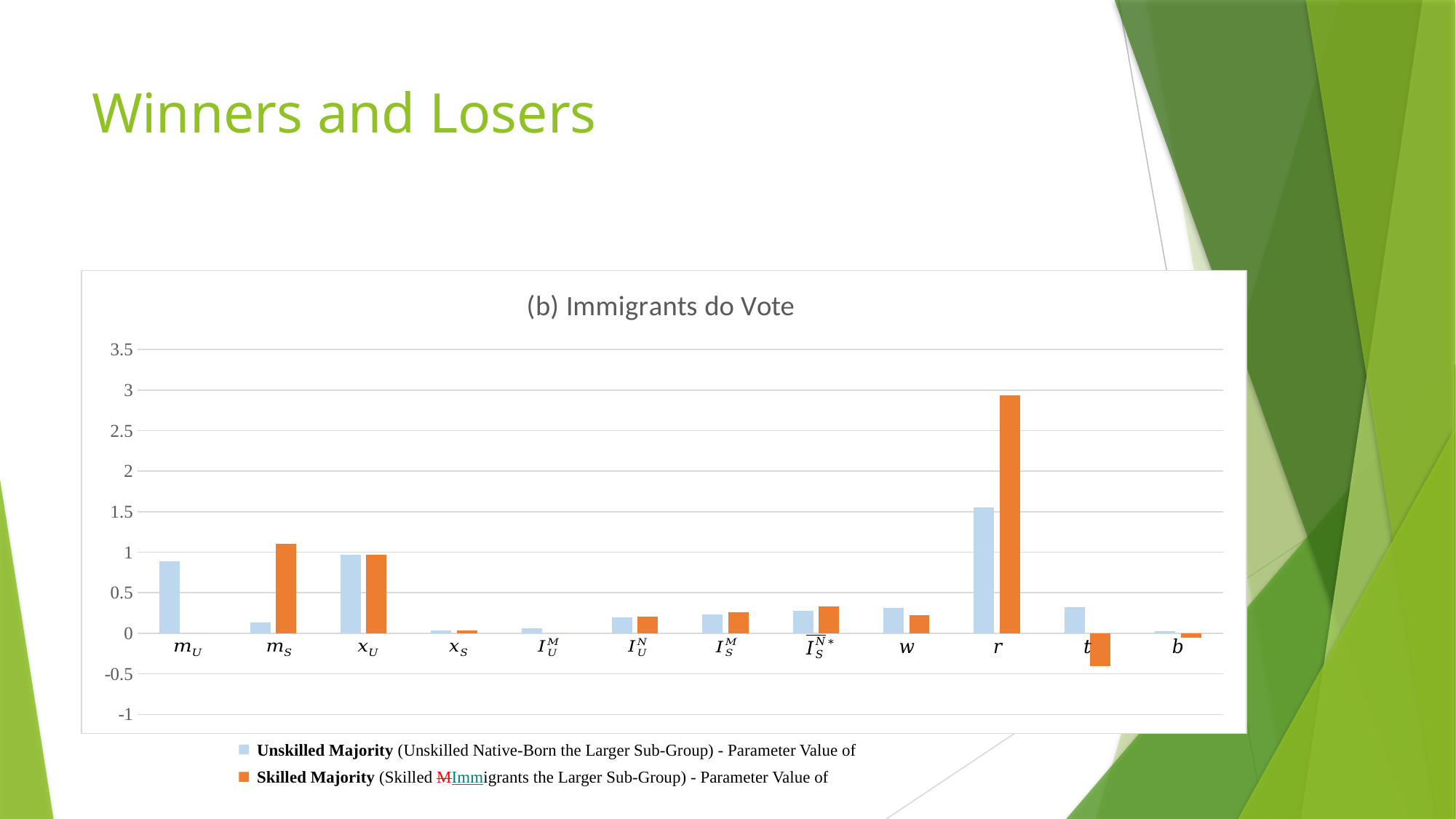
How many series does the legend list? 2 Is the Unskilled Majority value for m_U greater or less than 0.5? greater Which colour represents the Skilled Majority series? orange For which category is the Skilled Majority value highest? r What is the title of the chart? (b) Immigrants do Vote For which category is the Unskilled Majority value highest? r For which category is the Skilled Majority value lowest? t What kind of chart is shown on the slide? bar chart How many categories are shown on the x axis? 12 For category m_S, which series has the larger value, Unskilled Majority or Skilled Majority? Skilled Majority Is the Skilled Majority value for r greater or less than 2.5? greater Is the Skilled Majority value for t greater or less than 0? less